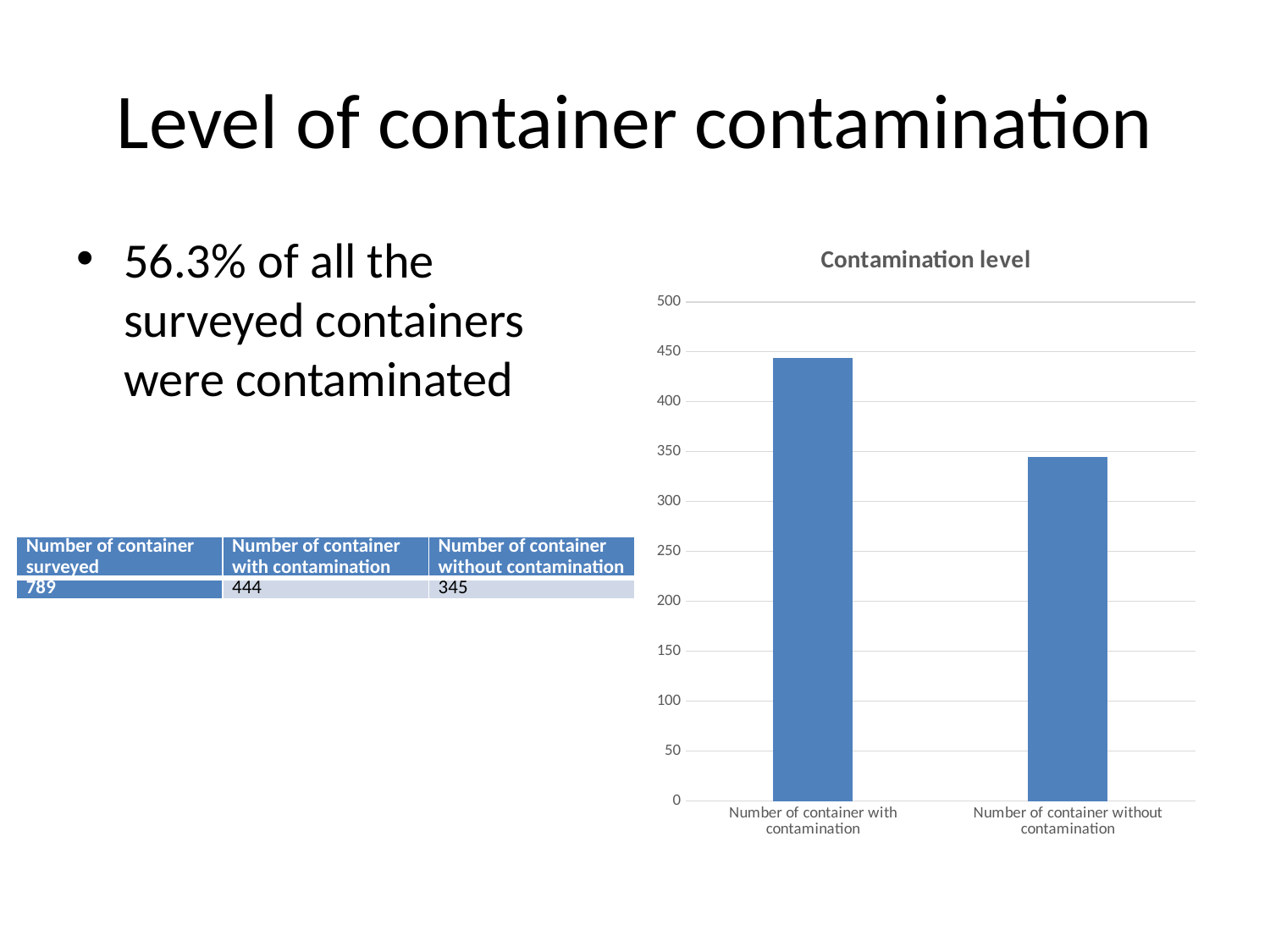
What is the difference between the value for Number of container with contamination and the value for Number of container without contamination? 99 What type of chart is shown on the slide? bar chart Is the value for Number of container without contamination greater or less than 350? less Which category has the highest bar in the chart? Number of container with contamination What is the title of the chart? Contamination level What is the value for Number of container without contamination? 345 Is the value for Number of container with contamination greater or less than 450? less Which is larger: the value for Number of container with contamination or the value for Number of container without contamination? Number of container with contamination How many categories are plotted in the chart? 2 What is the value for Number of container with contamination? 444 Is the value for Number of container with contamination greater or less than 400? greater Which category has the lowest bar in the chart? Number of container without contamination